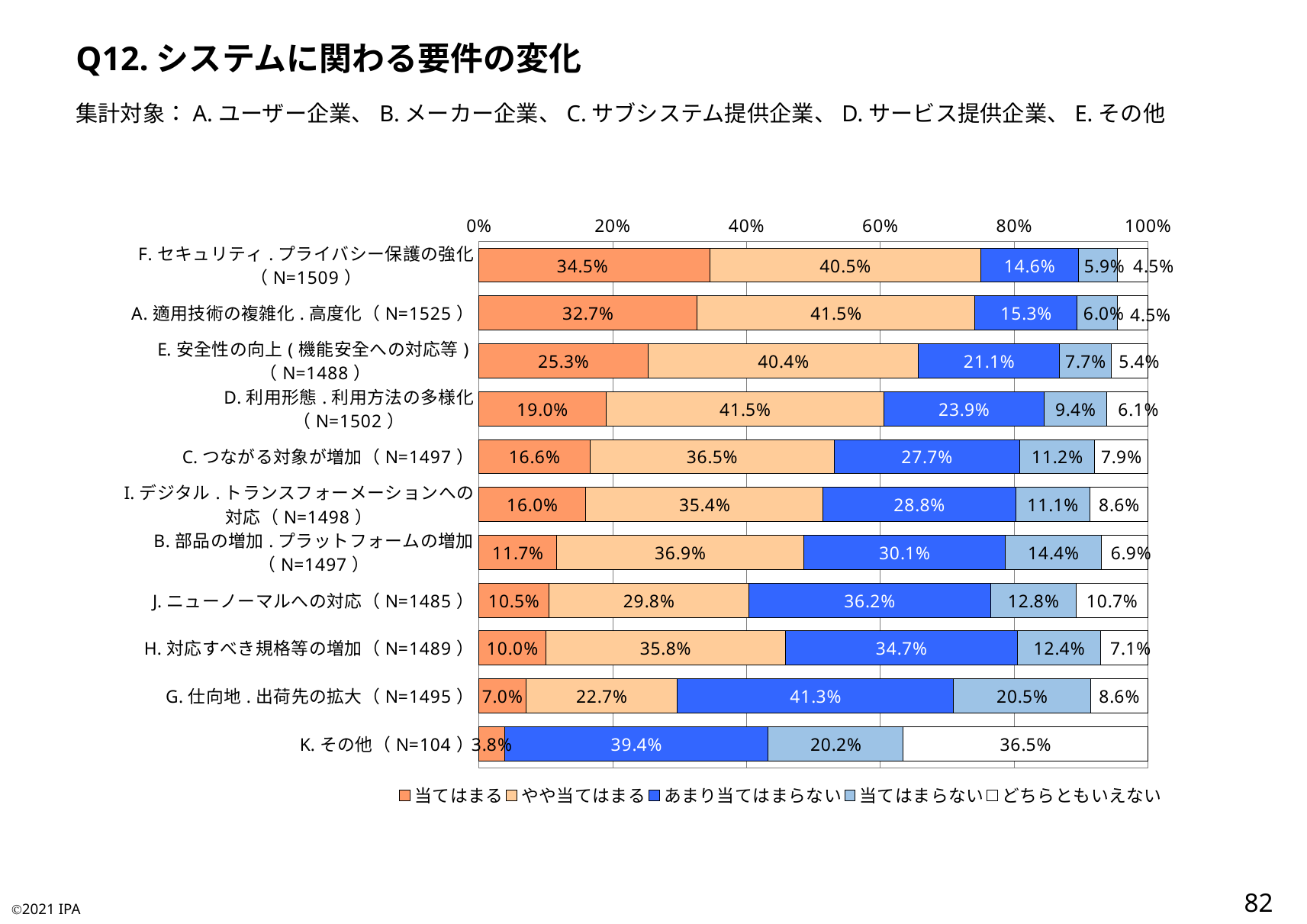
Which category has the highest 当てはまる value? F. セキュリティ.プライバシー保護の強化 How many series does the legend list? 5 Which category has the lowest 当てはまる value among those with a labelled 当てはまる segment (excluding K. その他)? G. 仕向地.出荷先の拡大 What is the どちらともいえない value for K. その他? 36.5% What is the あまり当てはまらない value for G. 仕向地.出荷先の拡大? 41.3% What is the やや当てはまる value for A. 適用技術の複雑化.高度化? 41.5% What is the difference between the 当てはまる values of F. セキュリティ.プライバシー保護の強化 and A. 適用技術の複雑化.高度化? 1.8% What is the 当てはまらない value for D. 利用形態.利用方法の多様化? 9.4% Which is larger: the あまり当てはまらない value for J. ニューノーマルへの対応 or for H. 対応すべき規格等の増加? J. ニューノーマルへの対応 What type of chart is shown on the slide? stacked bar chart How many categories (bars) are plotted in the chart? 11 What is the 当てはまる value for F. セキュリティ.プライバシー保護の強化? 34.5%